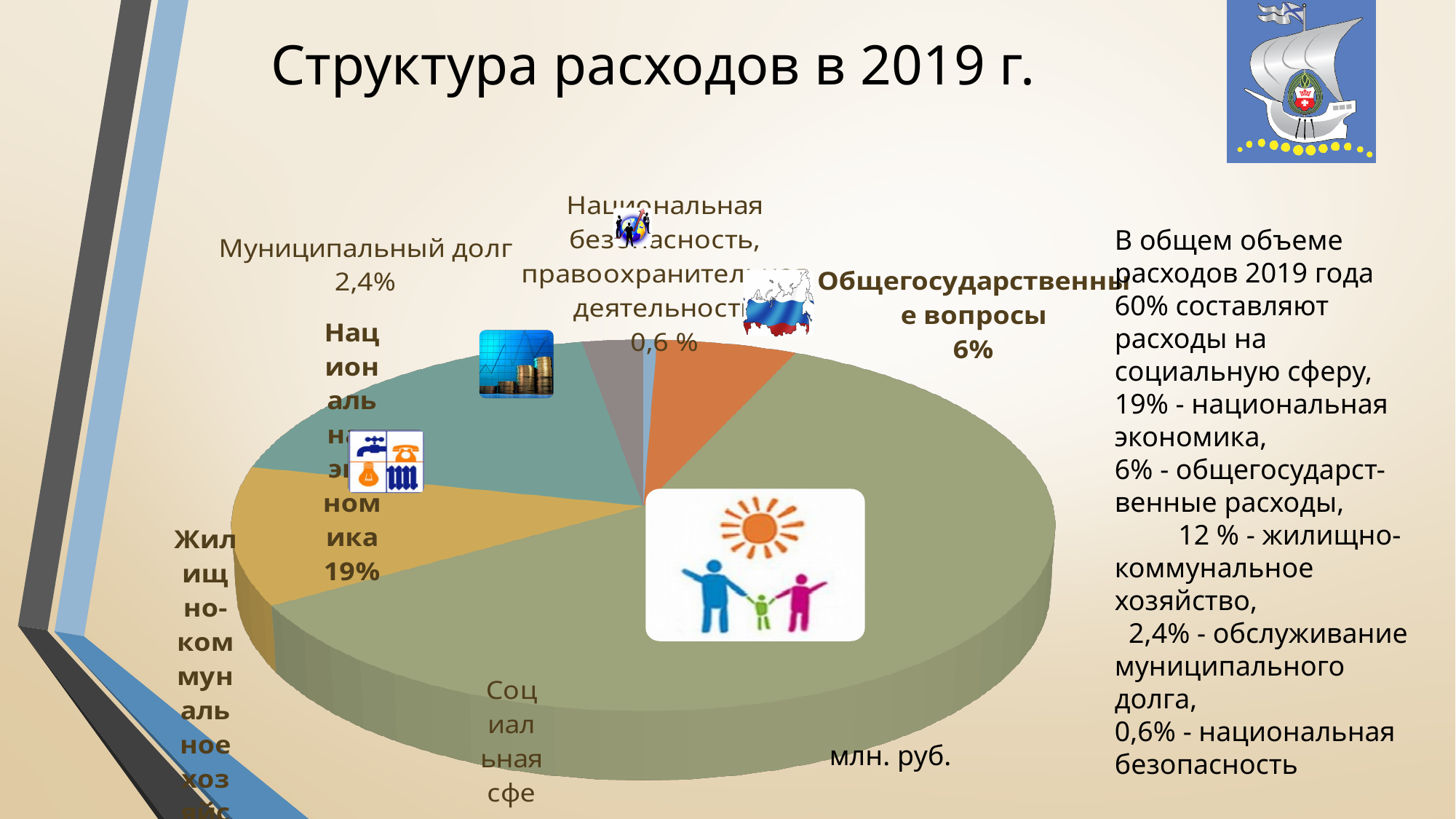
What is the difference in percentage points between Муниципальный долг and Национальная безопасность, правоохранительная деятельность? 1,8 What share of expenditures does Национальная безопасность, правоохранительная деятельность account for? 0,6 % What is the difference in percentage points between Национальная экономика and Общегосударственные вопросы? 13 Which category has the largest slice of the pie? Социальная сфера Which category has the smallest slice of the pie? Национальная безопасность, правоохранительная деятельность What share of expenditures does Национальная экономика account for? 19% How many slices does the pie chart have? 6 What is the title of the chart on the slide? Структура расходов в 2019 г. What share of expenditures does Общегосударственные вопросы account for? 6% What kind of chart is shown on the slide? pie chart What share of expenditures does Муниципальный долг account for? 2,4% Which is larger: the share for Национальная экономика or the share for Общегосударственные вопросы? Национальная экономика